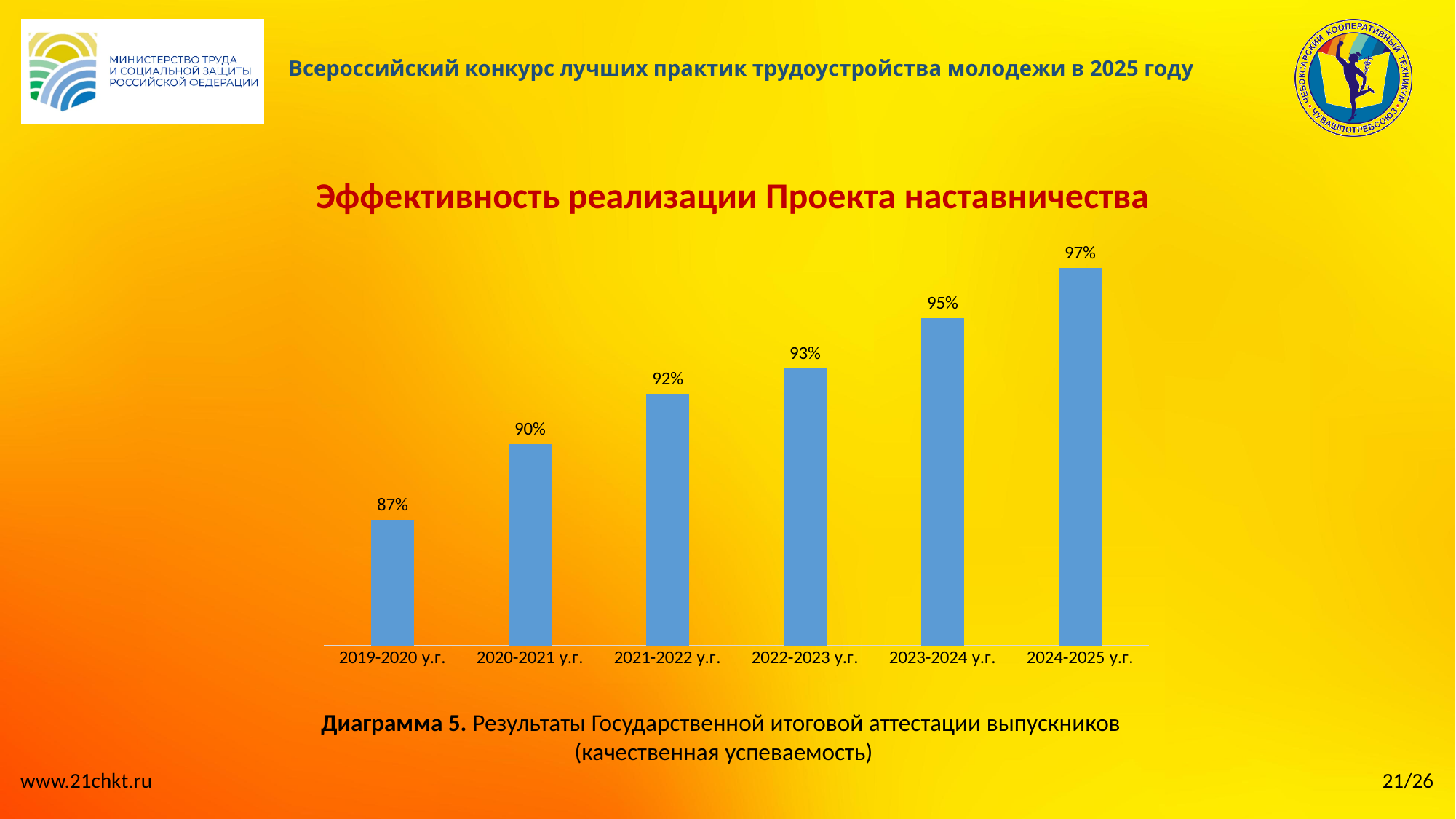
What is the value for 2019-2020 у.г.? 87% What kind of chart is shown on the slide? bar chart What is the value for 2021-2022 у.г.? 92% How many academic years are shown on the chart? 6 What is the value for 2023-2024 у.г.? 95% Which academic year has the highest value? 2024-2025 у.г. What is the difference between the values for 2024-2025 у.г. and 2019-2020 у.г.? 10% Do the values rise or fall from 2019-2020 у.г. to 2024-2025 у.г.? rise What is the difference between the values for 2022-2023 у.г. and 2020-2021 у.г.? 3% Which academic year has the lowest value? 2019-2020 у.г. What is the title of the chart? Диаграмма 5. Результаты Государственной итоговой аттестации выпускников (качественная успеваемость) Which is larger, the value for 2020-2021 у.г. or the value for 2022-2023 у.г.? 2022-2023 у.г.